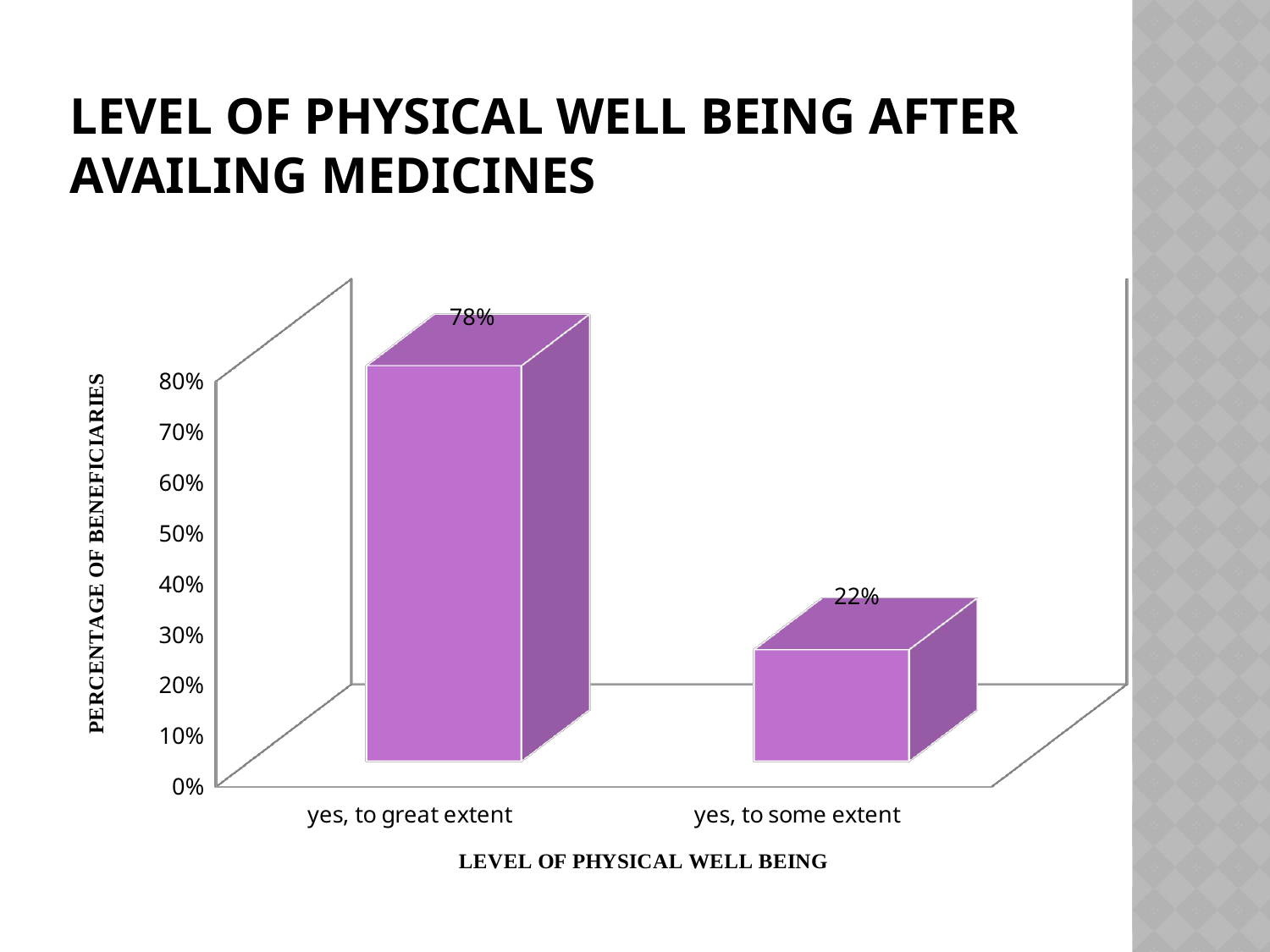
What is the difference in percentage points between "yes, to great extent" and "yes, to some extent"? 56% Is the value for "yes, to great extent" greater or less than 70%? greater Which category has the lowest percentage of beneficiaries? yes, to some extent What percentage of beneficiaries answered "yes, to some extent"? 22% What percentage of beneficiaries answered "yes, to great extent"? 78% Is the value for "yes, to some extent" greater or less than 30%? less How many categories are shown on the x axis of the chart? 2 Which category has the highest percentage of beneficiaries? yes, to great extent What is the label of the horizontal axis of the chart? LEVEL OF PHYSICAL WELL BEING Which is larger: the value for "yes, to great extent" or the value for "yes, to some extent"? yes, to great extent What is the label of the vertical axis of the chart? PERCENTAGE OF BENEFICIARIES What kind of chart is shown on the slide? bar chart